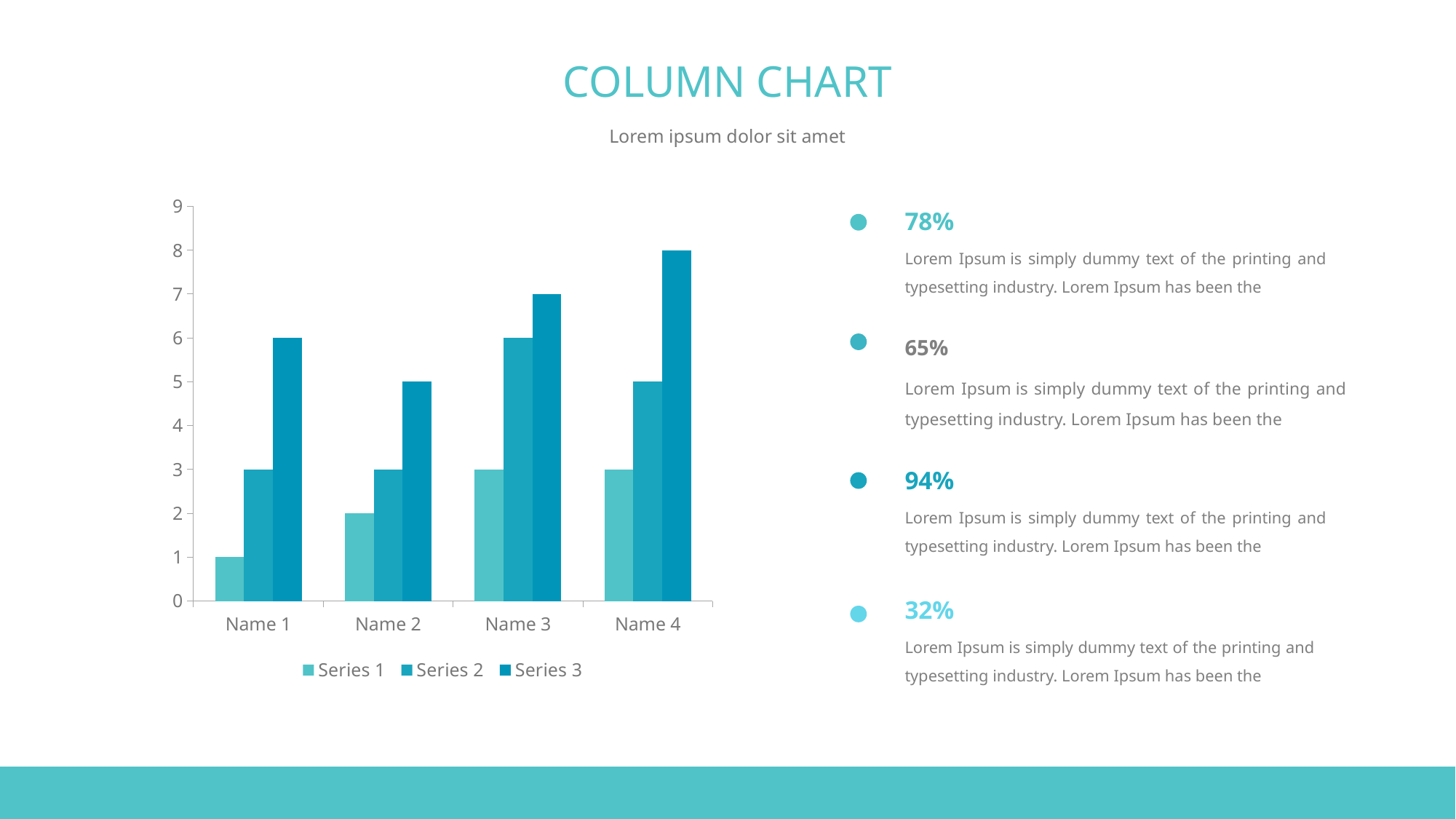
What is the value of Series 3 for Name 4? 8 What is the value of Series 1 for Name 1? 1 Is the value of Series 3 for Name 3 greater or less than 5? greater How many series does the chart legend list? 3 Which category has the lowest Series 1 value? Name 1 What type of chart is shown on the slide? bar chart Which is larger for Name 2: the Series 2 value or the Series 3 value? Series 3 What is the difference between the Series 3 value for Name 4 and the Series 3 value for Name 2? 3 What is the value of Series 2 for Name 3? 6 Which category has the highest Series 3 value? Name 4 What is the title of the chart slide? COLUMN CHART How many categories are shown on the x axis of the chart? 4